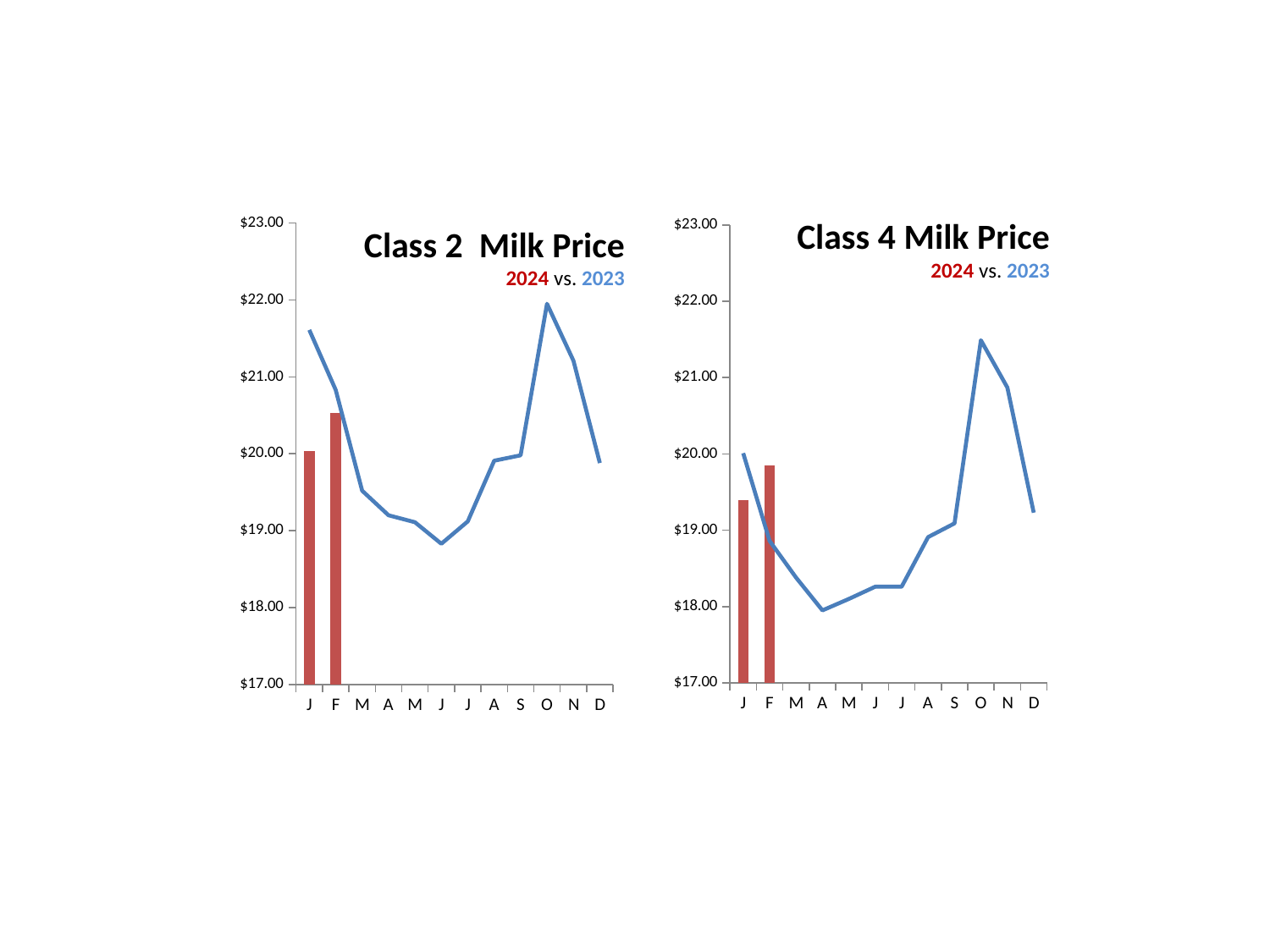
What colour represents 2024 on the Class 2 Milk Price chart? red On the Class 4 Milk Price chart, is the 2024 value for J (January) greater or less than $20.00? less On the Class 4 Milk Price chart, is the 2023 value for D (December) greater or less than $20.00? less On the Class 2 Milk Price chart, which 2024 bar is taller, J (January) or F (February)? F How many 2024 bars are plotted on the Class 4 Milk Price chart? 2 On the Class 4 Milk Price chart, in which month does the 2023 line reach its highest value? O On the Class 2 Milk Price chart, in which month does the 2023 line reach its highest value? O On the Class 4 Milk Price chart, for J (January), which is higher: the 2024 bar or the 2023 line? 2023 On the Class 4 Milk Price chart, does the 2023 line rise or fall from O to D? fall On the Class 2 Milk Price chart, is the 2024 value for F (February) greater or less than $20.00? greater